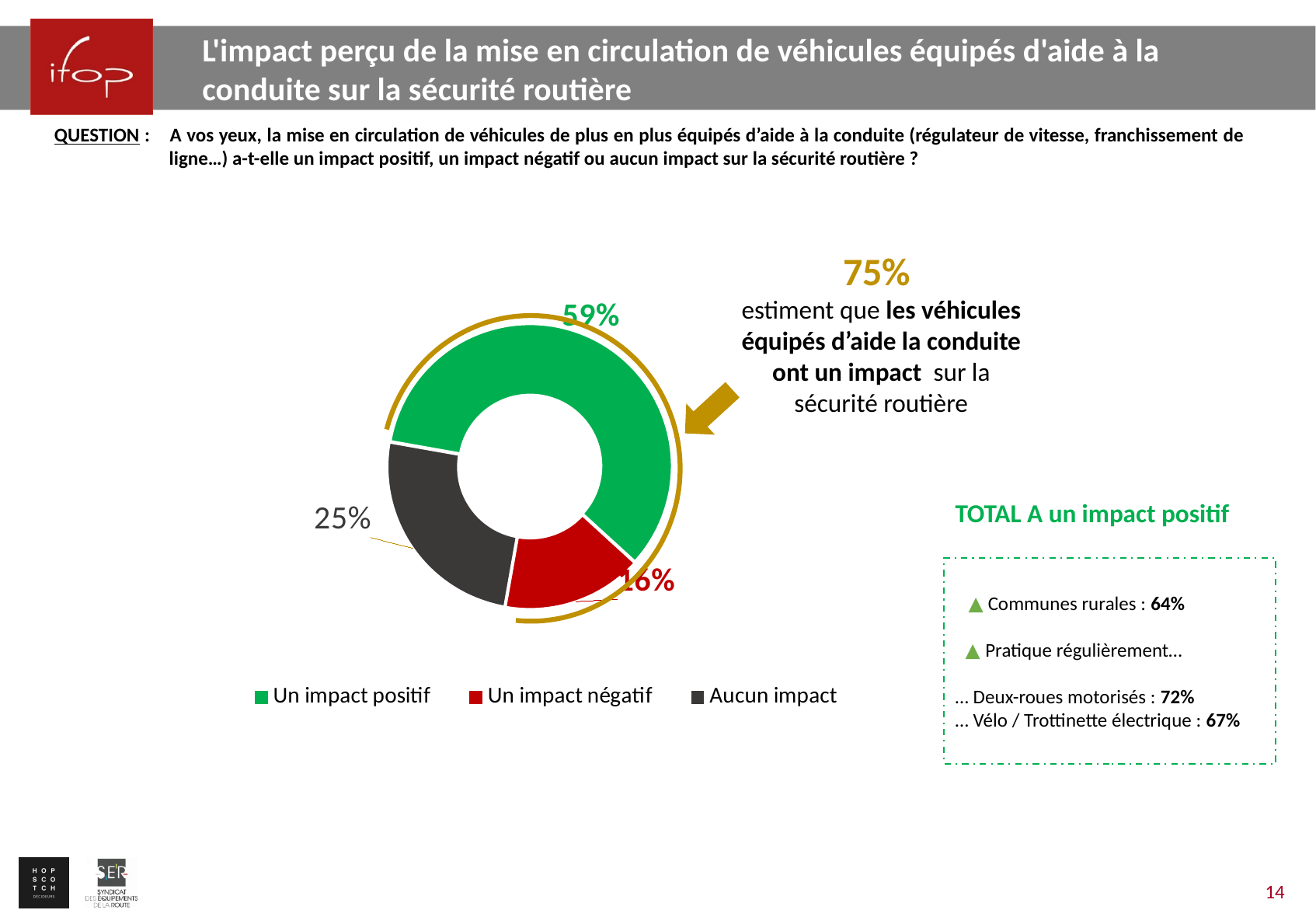
Which response has the largest share of the pie? Un impact positif What kind of chart is shown on the slide? Pie chart (donut) What percentage of respondents answered "Un impact positif"? 59% Which response has the smallest share of the pie? Un impact négatif What percentage of respondents answered "Un impact négatif"? 16% How many categories does the pie chart show? 3 What is the difference in percentage points between "Un impact positif" and "Aucun impact"? 34 What colour represents "Aucun impact" in the chart? Dark grey What is the combined share of "Un impact positif" and "Un impact négatif"? 75% What percentage of respondents answered "Aucun impact"? 25% Which legend entry is shown in red? Un impact négatif Which is larger: the share for "Aucun impact" or the share for "Un impact négatif"? Aucun impact